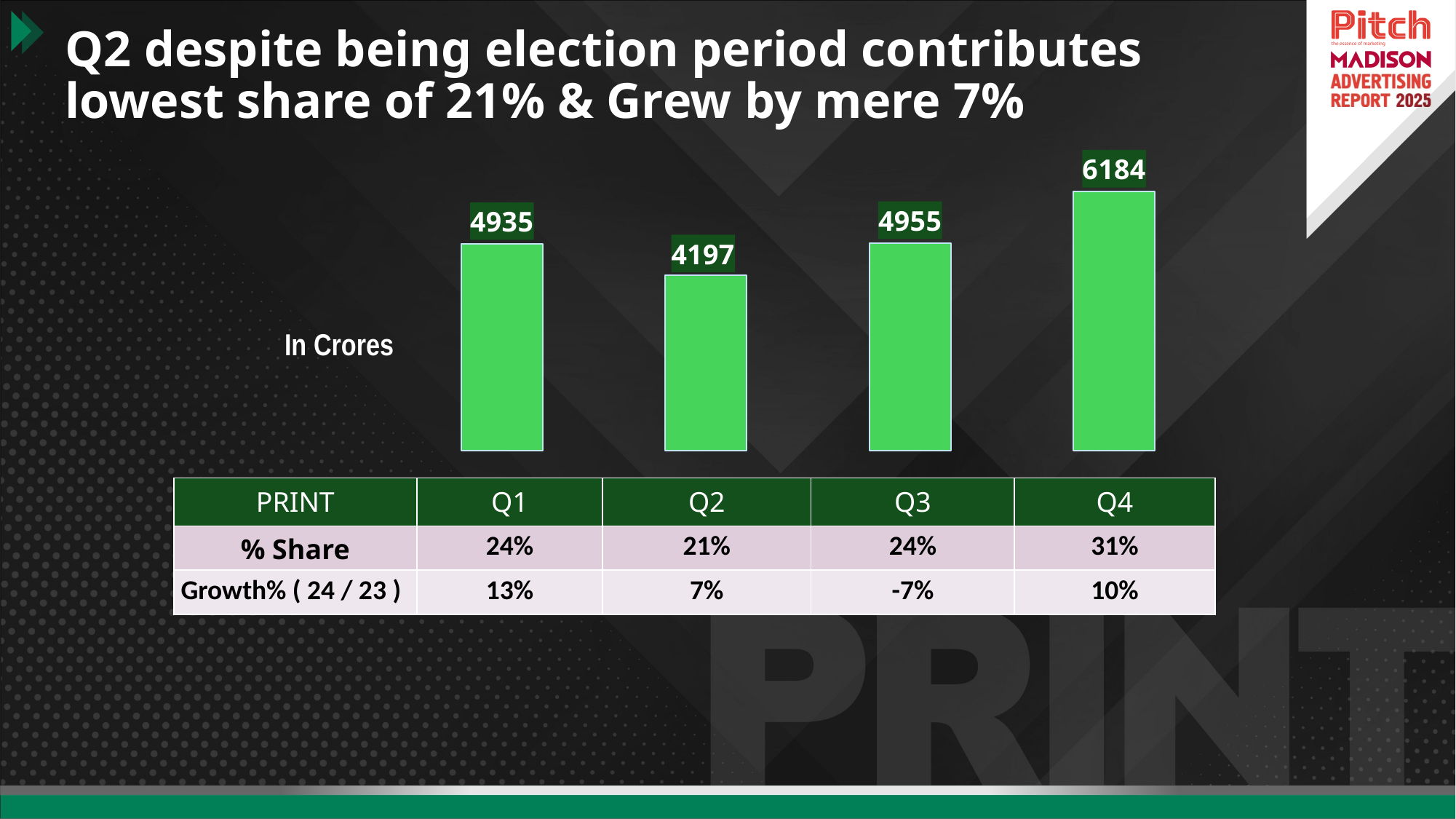
Which quarter has the highest value in the bar chart? Q4 Which quarter has the lowest value in the bar chart? Q2 What unit label is shown next to the bar chart? In Crores What is the difference between the Q4 and Q2 values in the bar chart? 1987 What is the value for Q3 in the bar chart? 4955 What kind of chart is shown on the slide? Bar chart What is the value for Q1 in the bar chart? 4935 What is the value for Q4 in the bar chart? 6184 How many bars are plotted in the chart? 4 Which is larger in the bar chart, the value for Q1 or the value for Q2? Q1 What is the difference between the Q3 and Q1 values in the bar chart? 20 What is the value for Q2 in the bar chart? 4197